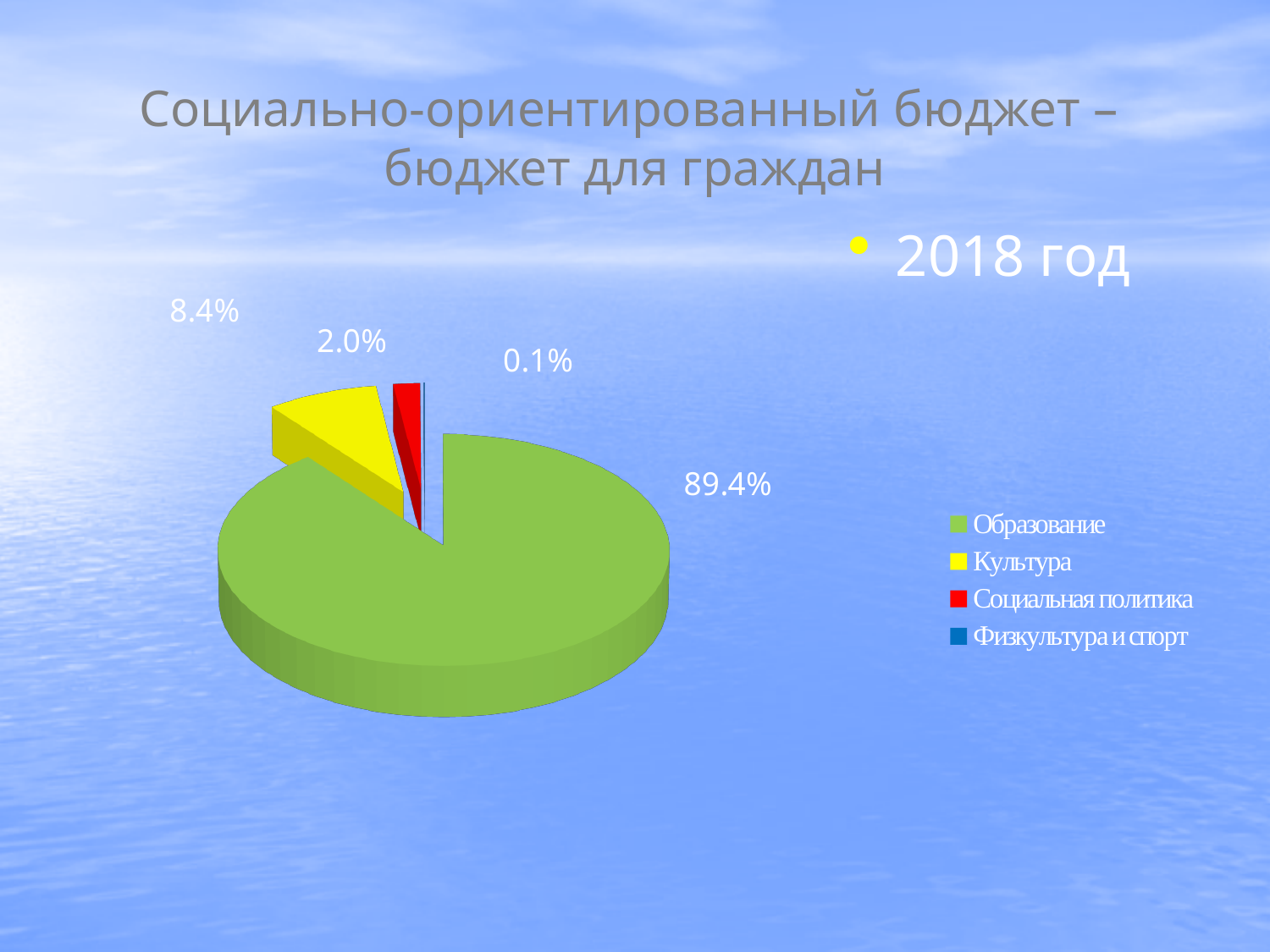
What share of the pie does Культура have? 8.4% What share of the pie does Образование have? 89.4% Which category has the smallest slice of the pie? Физкультура и спорт What kind of chart is shown on the slide? pie chart Which is larger, the share for Культура or the share for Социальная политика? Культура Which category has the largest slice of the pie? Образование What share of the pie does Социальная политика have? 2.0% What colour is the slice for Культура? yellow How many slices does the pie chart have? 4 How many entries does the legend list? 4 What is the difference in percentage points between the shares of Образование and Культура? 81.0 What share of the pie does Физкультура и спорт have? 0.1%